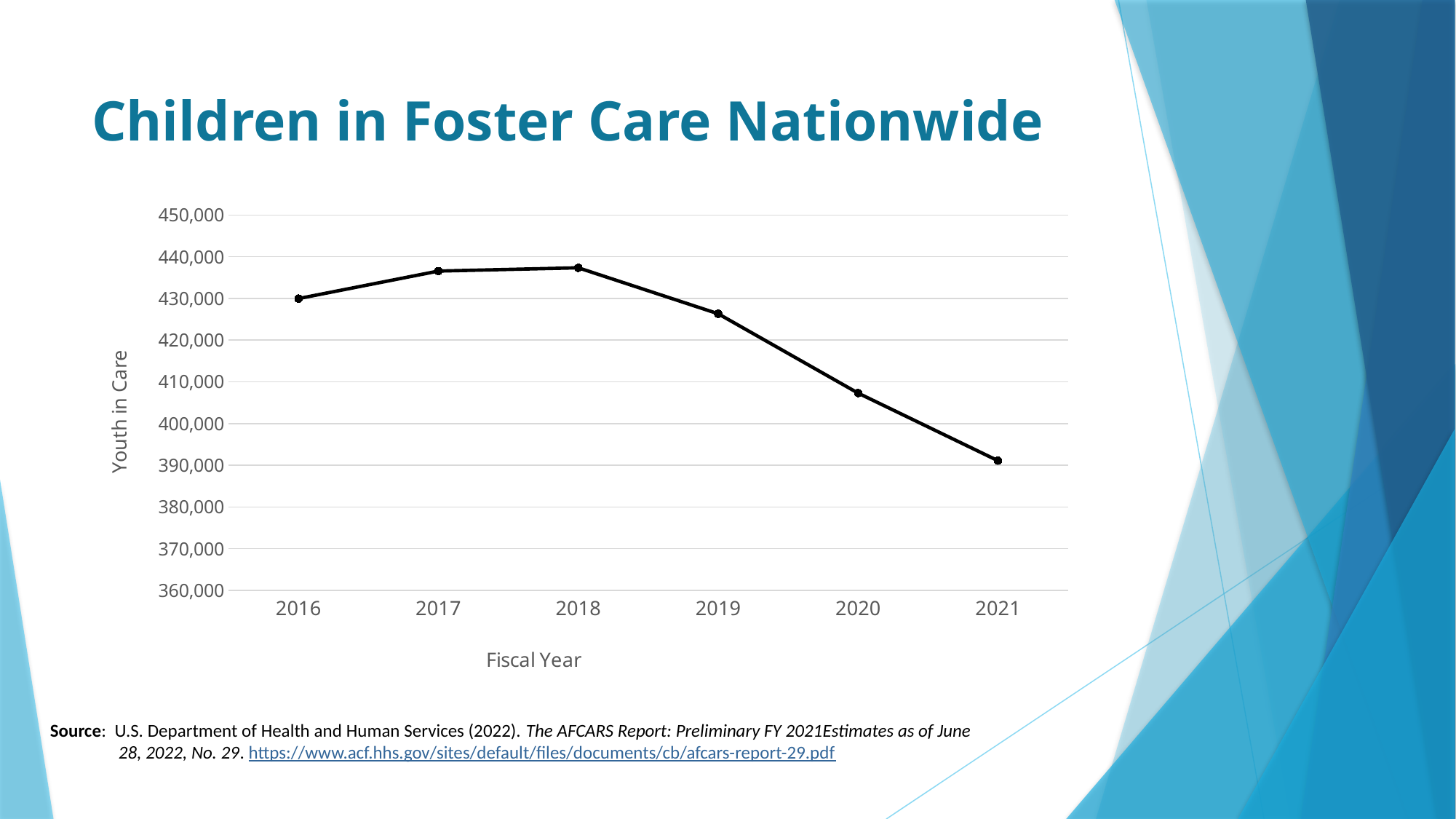
What kind of chart is shown on the slide? line chart Which fiscal year has the lowest number of youth in care? 2021 Which year has the larger value, 2016 or 2021? 2016 Is the value for 2018 greater or less than 440,000? less Is the value for 2020 greater or less than 400,000? greater Is the value for 2017 greater or less than 430,000? greater How many fiscal years are plotted on the chart? 6 What is the label on the vertical axis of the chart? Youth in Care Do the values rise or fall from 2018 to 2021? fall Which year has the larger value, 2019 or 2020? 2019